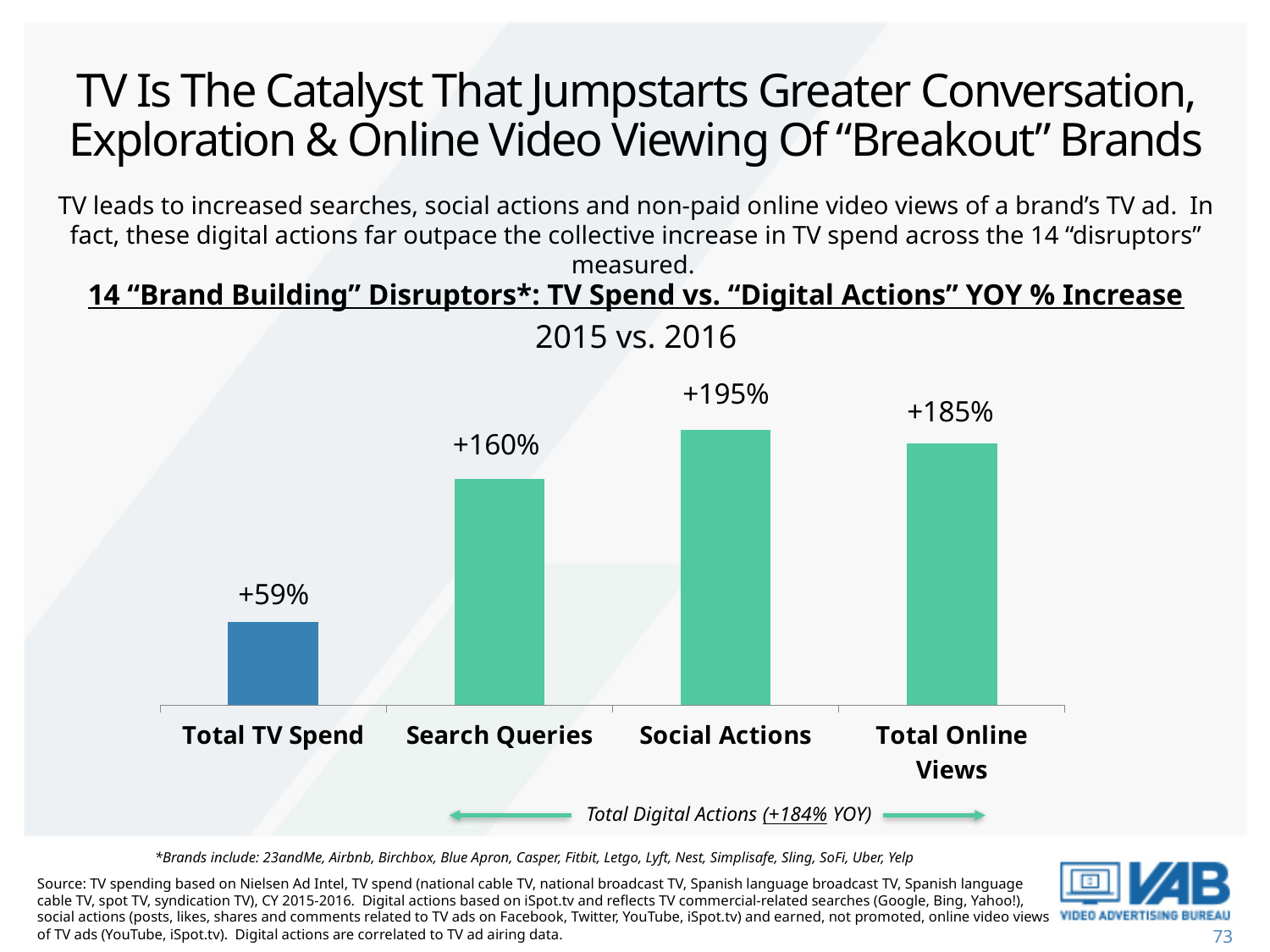
How many categories are shown in the chart? 4 Which category has the lowest YOY % increase? Total TV Spend What YOY % increase is given for Total Digital Actions below the chart? +184% What type of chart is shown on the slide? Bar chart What is the difference in YOY % increase between Social Actions and Total TV Spend? 136 percentage points What is the difference in YOY % increase between Search Queries and Total Online Views? 25 percentage points Which category has the highest YOY % increase? Social Actions What is the YOY % increase for Total TV Spend? +59% What is the YOY % increase for Search Queries? +160% Which has a larger YOY % increase, Search Queries or Total Online Views? Total Online Views What is the YOY % increase for Total Online Views? +185% What is the YOY % increase for Social Actions? +195%